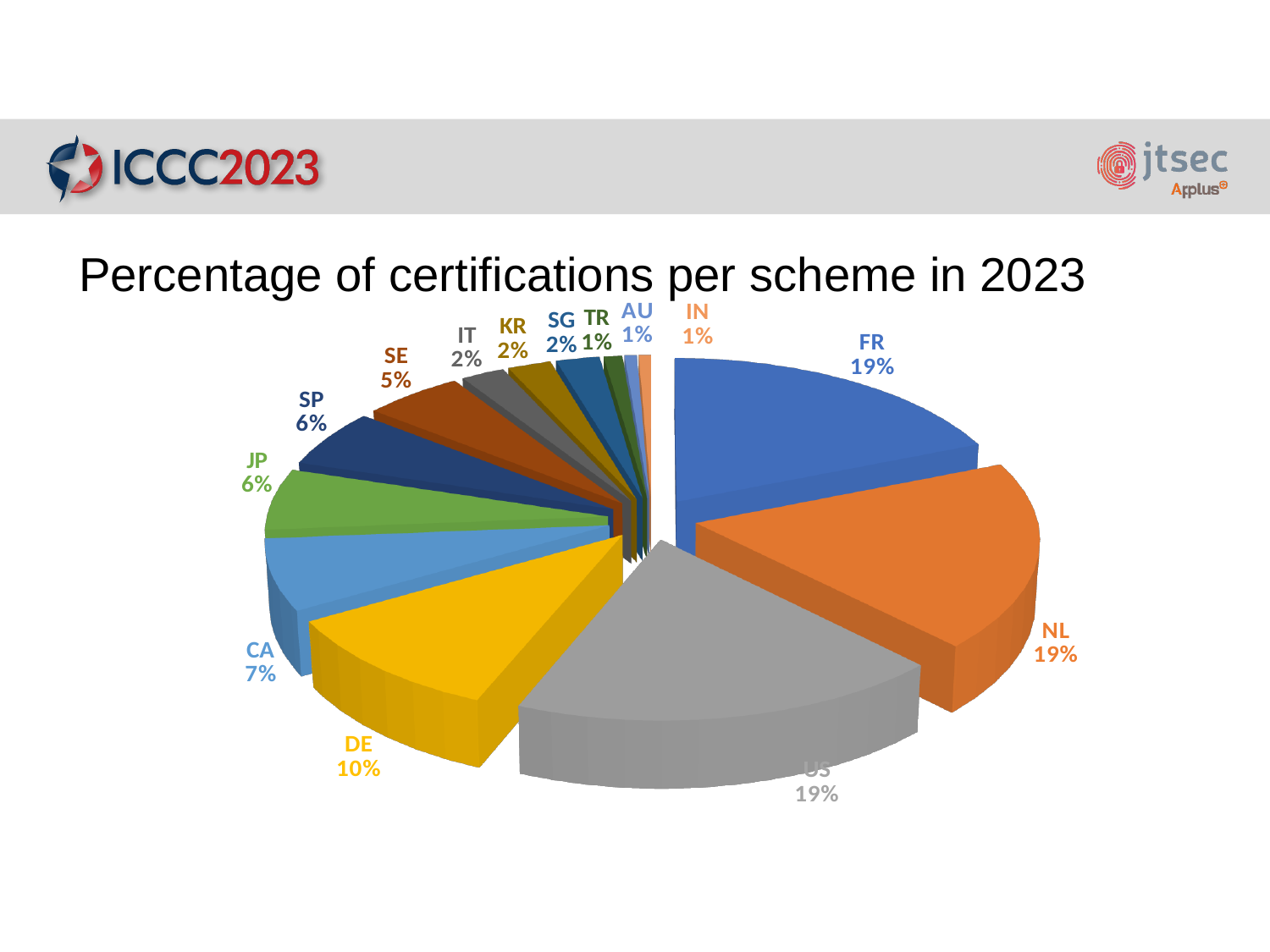
What is the share shown for the CA slice? 7% What percentage of certifications does the DE scheme account for? 10% What percentage is shown for the FR scheme? 19% How many schemes are shown in the pie chart? 14 What is the difference in percentage points between NL and DE? 9% What percentage is shown for the SE scheme? 5% What percentage is shown for the IN scheme? 1% Which has a larger share, SP or SE? SP Which has a larger share, DE or CA? DE What is the difference in percentage points between DE and CA? 3% What percentage is shown for the JP scheme? 6% What kind of chart is shown on the slide? Pie chart